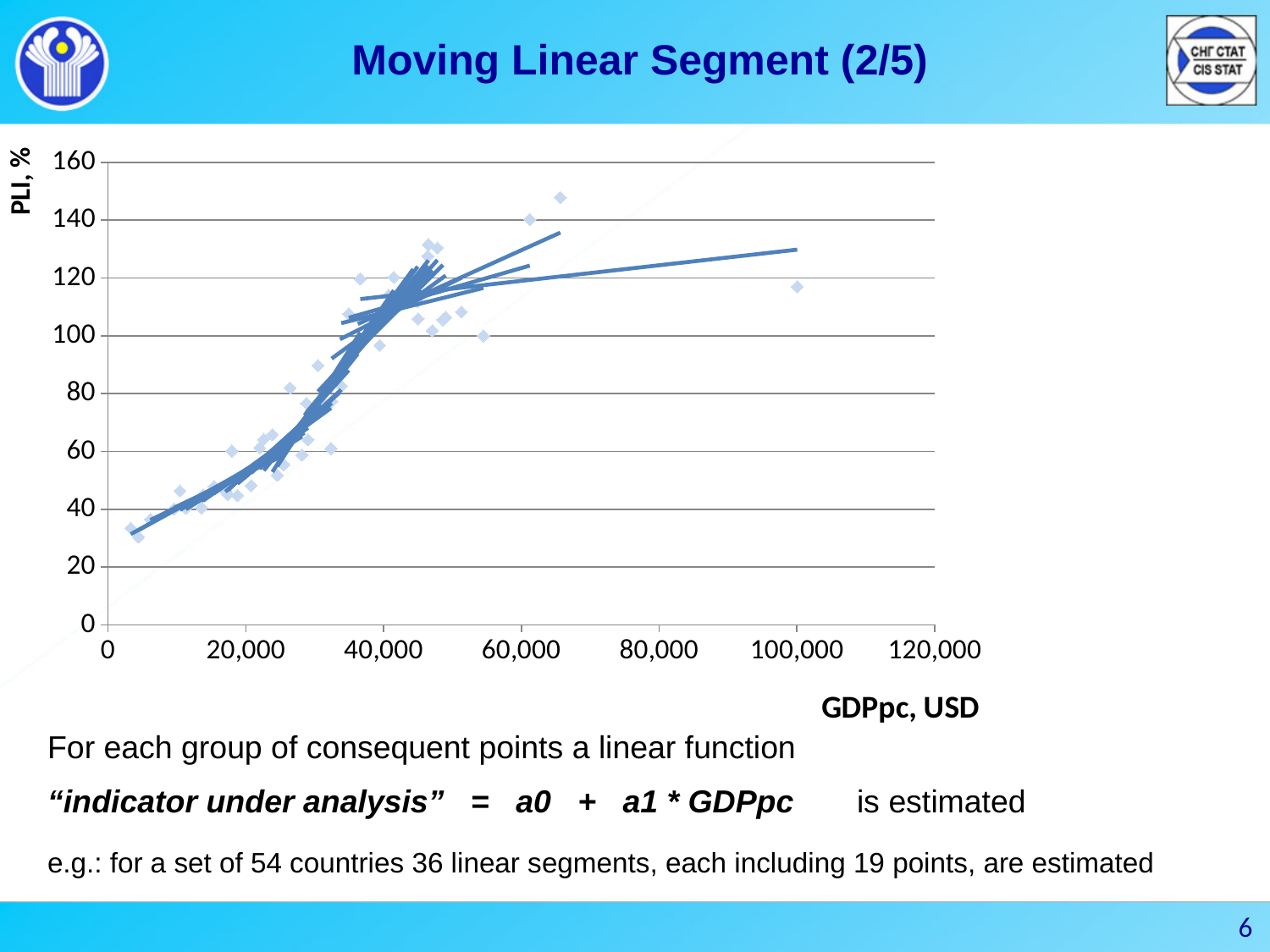
What is the label of the vertical axis? PLI, % Is the PLI value of the points near 20,000 USD GDPpc greater or less than 80? less Is the PLI value of the point near 60,000 USD GDPpc greater or less than 120? greater Do the PLI values generally rise or fall as GDPpc increases along the x axis? rise Is the PLI value of the points near 40,000 USD GDPpc greater or less than 80? greater Which have higher PLI values: the points near 10,000 USD GDPpc or the points near 40,000 USD GDPpc? the points near 40,000 USD GDPpc What kind of chart is shown on the slide? scatter chart What is the label of the horizontal axis? GDPpc, USD